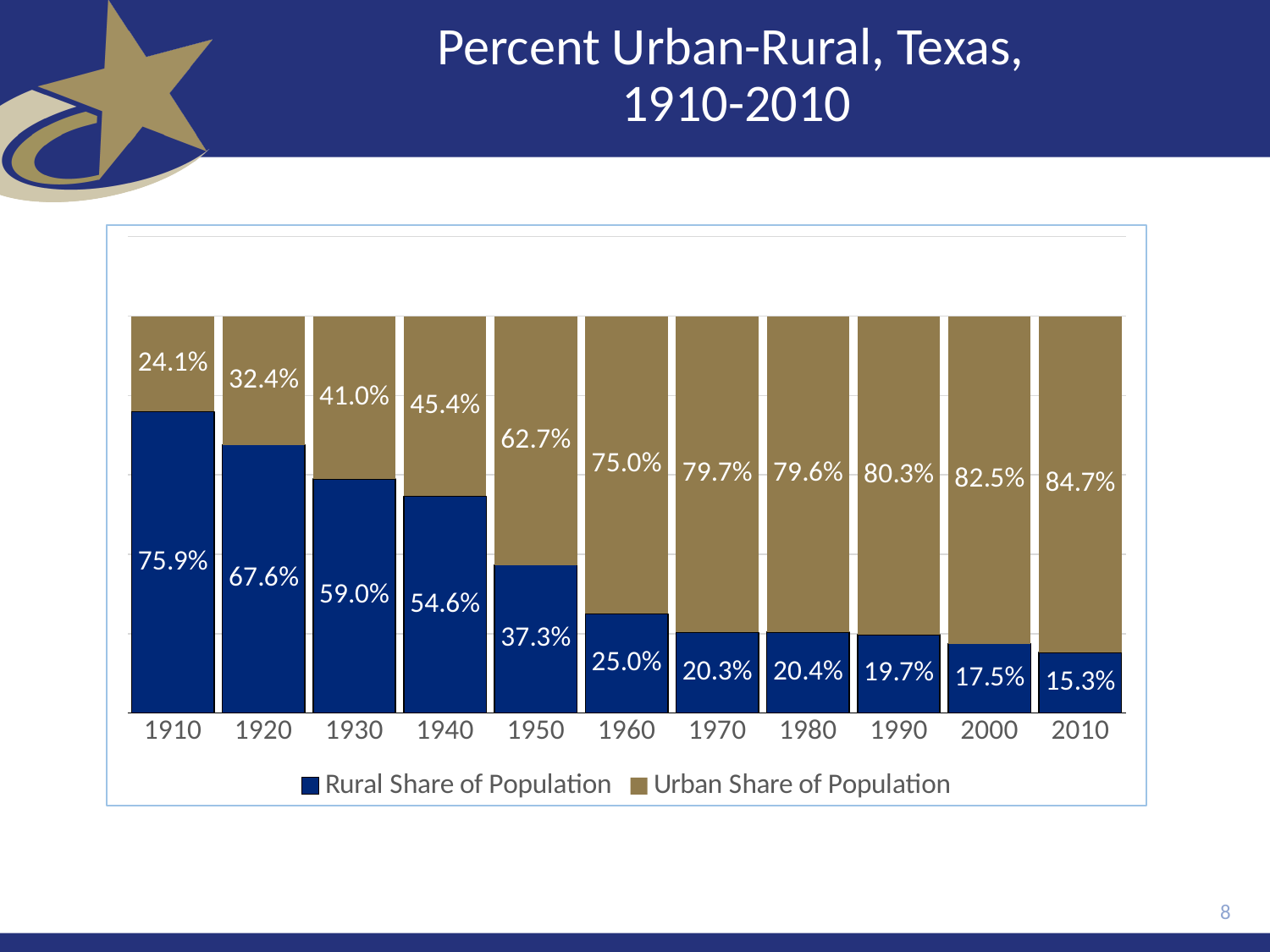
What is the difference between the Urban Share of Population in 2010 and in 1910? 60.6% How many years are shown on the x axis? 11 In which year is the Rural Share of Population highest? 1910 What kind of chart is shown? Stacked bar chart Does the Rural Share of Population generally rise or fall from 1910 to 2010? Fall What is the Rural Share of Population in 1910? 75.9% What is the Rural Share of Population in 1980? 20.4% In which year is the Urban Share of Population lowest? 1910 Which is larger in 1940, the Rural Share of Population or the Urban Share of Population? Rural Share of Population What is the Urban Share of Population in 2010? 84.7% What is the Urban Share of Population in 1950? 62.7% How many series does the legend list? 2